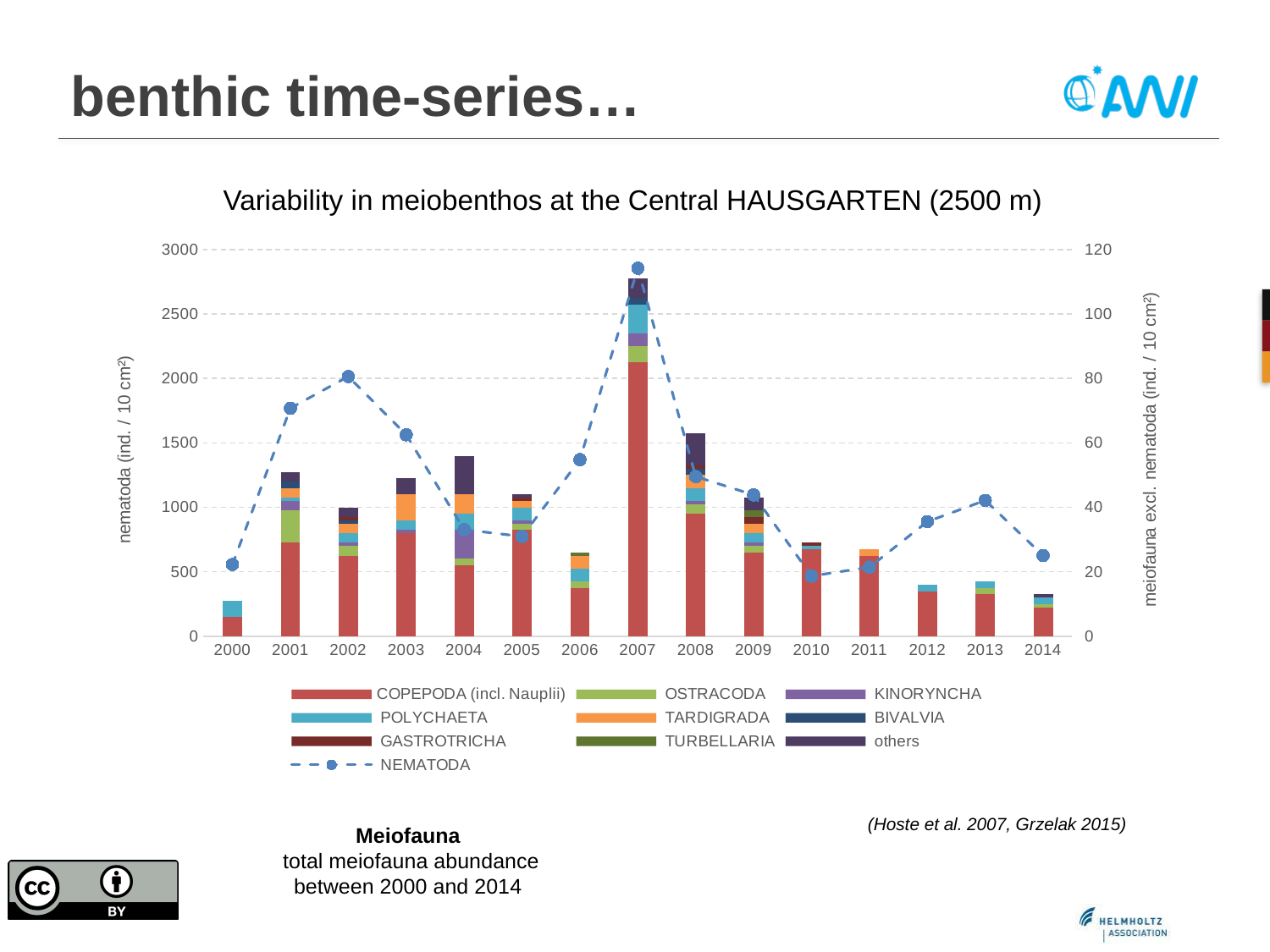
What is the title of the chart? Variability in meiobenthos at the Central HAUSGARTEN (2500 m) In which year does the NEMATODA line reach its highest value? 2007 In which year is the stacked bar (meiofauna excl. nematoda) tallest? 2007 Is the NEMATODA value for 2012 greater or less than 1000 on the left axis? less Does the NEMATODA line rise or fall from 2000 to 2002? rise What kind of chart is shown on the slide? A combination chart of stacked bars and a dashed line Which series is plotted as the dashed line with markers? NEMATODA How many series does the legend list? 10 Is the NEMATODA value for 2007 greater or less than 2500 on the left axis? greater Is the total stacked bar for 2007 greater or less than 100 on the right axis? greater Which year has the higher NEMATODA value, 2001 or 2003? 2001 How many years are shown along the x axis? 15